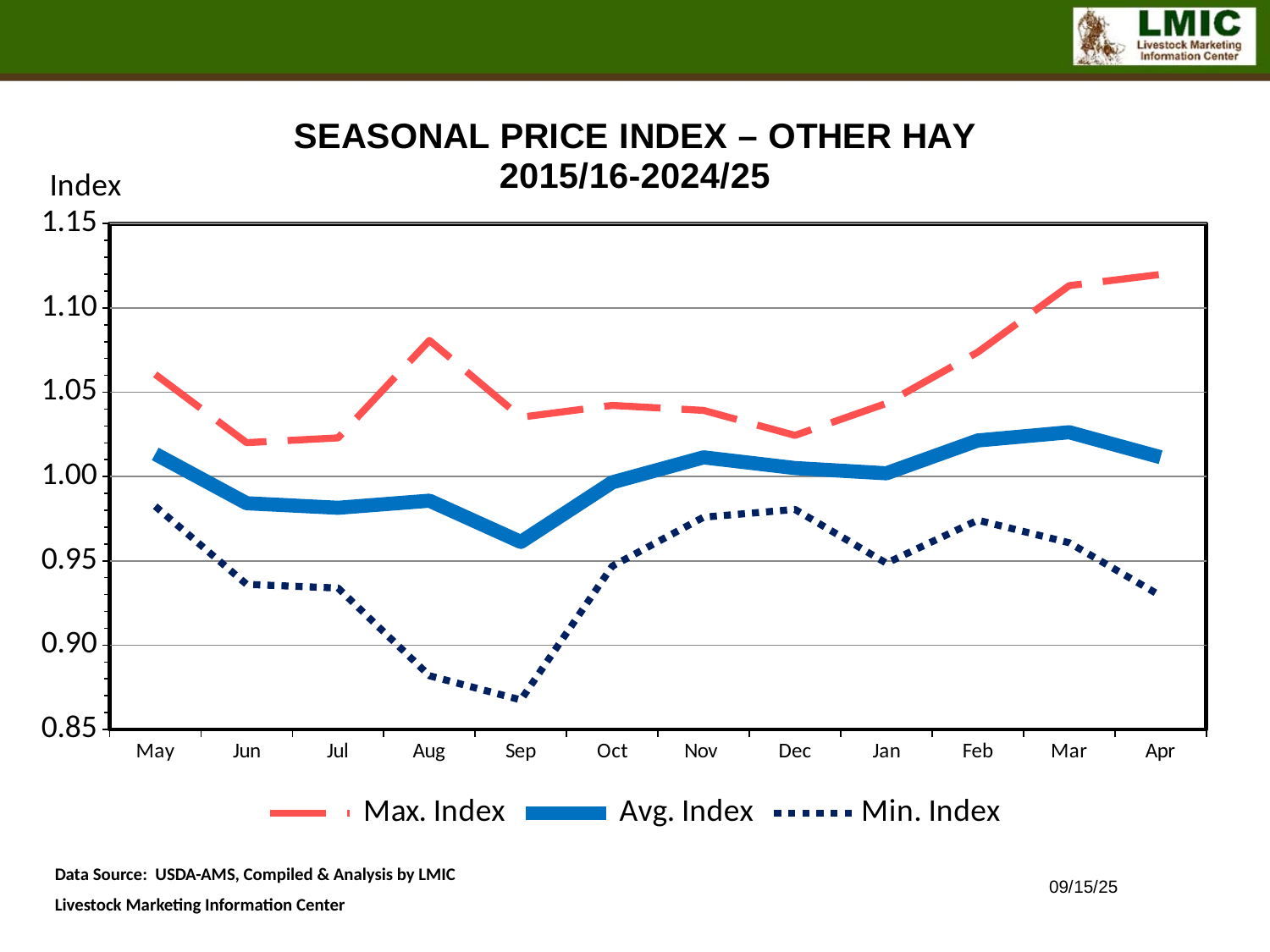
In which month is the Avg. Index at its lowest? Sep In which month is the Min. Index at its lowest? Sep Which is larger in Sep, the Max. Index or the Avg. Index? Max. Index Is the Max. Index value for Apr greater or less than 1.10? greater In which month is the Avg. Index at its highest? Mar What kind of chart is shown on the slide? line chart How many months are plotted along the x axis? 12 What is the title of the chart? SEASONAL PRICE INDEX – OTHER HAY 2015/16-2024/25 How many series does the legend list? 3 Does the Max. Index rise or fall from Dec to Apr? rise Is the Max. Index value for Aug greater or less than 1.05? greater Is the Min. Index value for Sep greater or less than 0.90? less